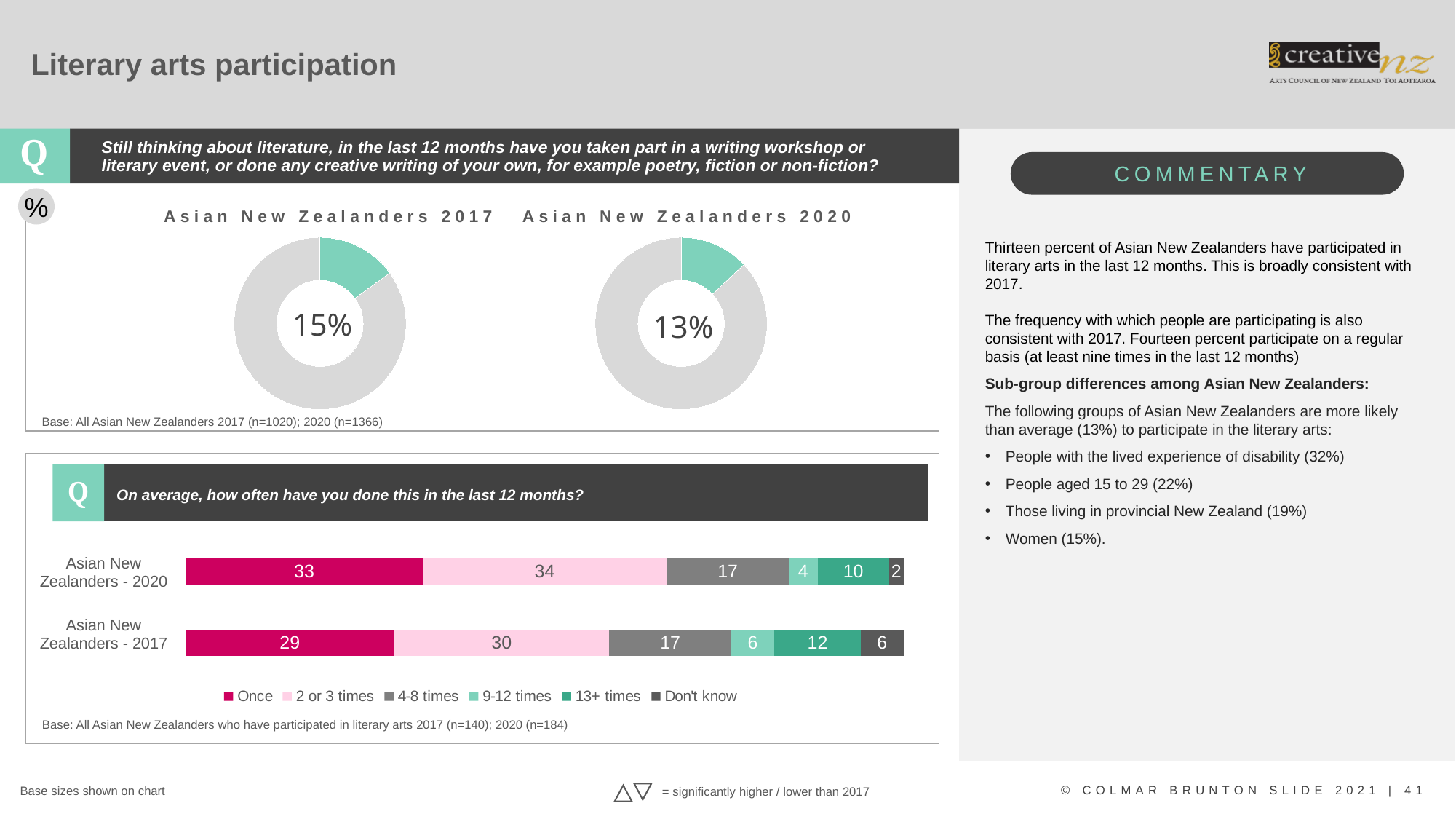
Comparing the two donut charts, which year shows the higher participation percentage, 2017 or 2020? 2017 What type of chart is used at the bottom of the slide to show how often people participated? Stacked bar chart In the donut chart titled 'Asian New Zealanders 2020', what percentage is shown in the centre? 13% In the stacked bar chart at the bottom, what is the difference between the 'Once' values for 2020 and 2017? 4 In the stacked bar chart at the bottom, how many series does the legend list? 6 In the stacked bar chart at the bottom, which segment is the smallest for Asian New Zealanders - 2020? Don't know In the stacked bar chart at the bottom, what is the value for '13+ times' for Asian New Zealanders - 2020? 10 In the stacked bar chart at the bottom, what is the value for '2 or 3 times' for Asian New Zealanders - 2017? 30 What is the difference between the percentages shown in the 2017 and 2020 donut charts? 2 percentage points In the donut chart titled 'Asian New Zealanders 2017', what percentage is shown in the centre? 15% In the stacked bar chart at the bottom, what is the value for 'Once' for Asian New Zealanders - 2020? 33 In the stacked bar chart at the bottom, which segment is the largest for Asian New Zealanders - 2020? 2 or 3 times